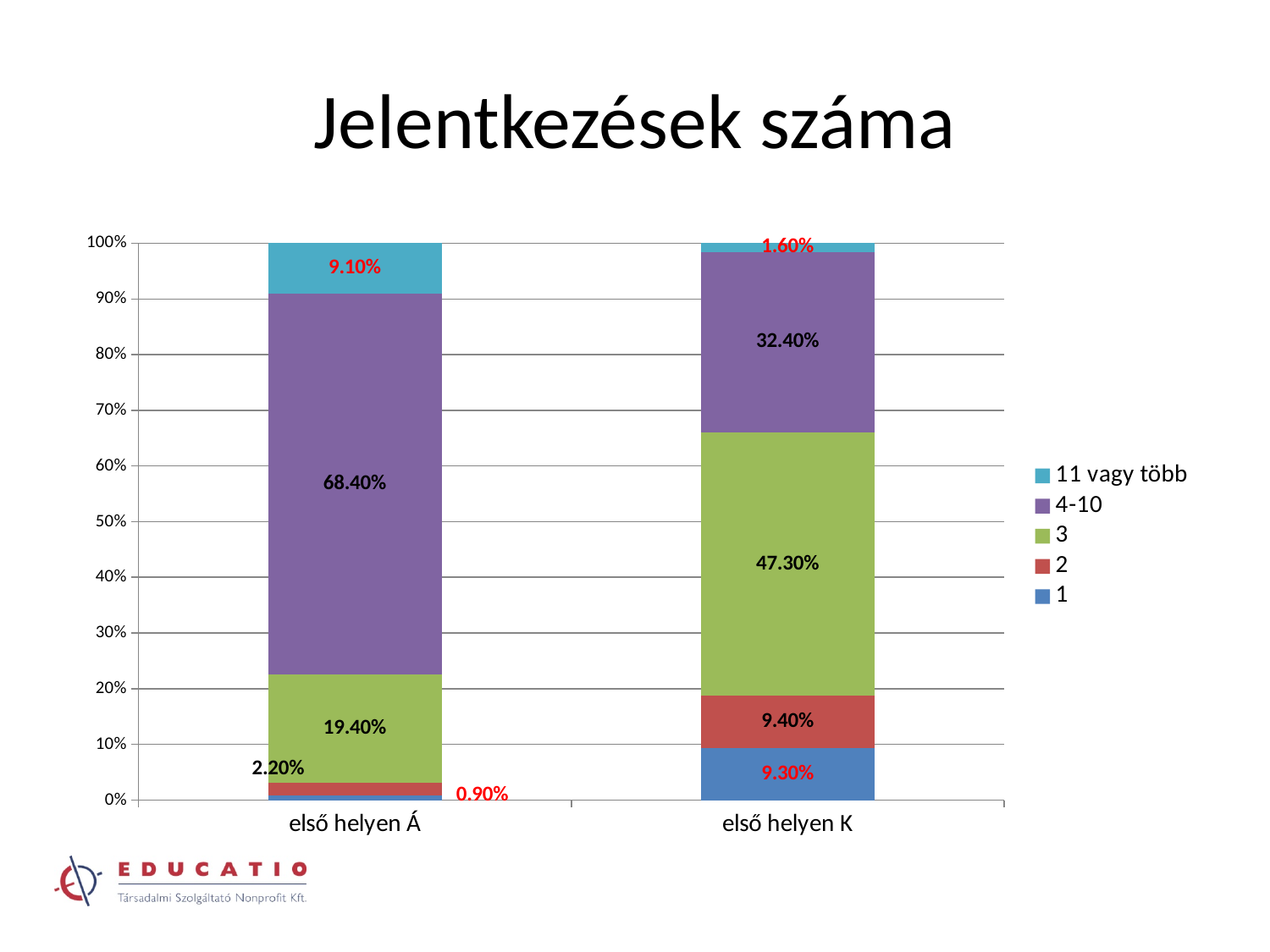
Which series has the smallest share in the első helyen Á bar? 1 Which category has the larger value for the 2 series, első helyen Á or első helyen K? első helyen K What is the value of the 4-10 series for első helyen Á? 68.40% What is the difference between the 4-10 values for első helyen Á and első helyen K? 36.00% Which series has the largest share in the első helyen K bar? 3 What is the value of the 11 vagy több series for első helyen K? 1.60% What kind of chart is shown on the slide? stacked bar chart How many series does the legend list? 5 What is the title of the chart? Jelentkezések száma How many categories are shown on the x axis? 2 What is the value of the 3 series for első helyen K? 47.30% What is the value of the 1 series for első helyen Á? 0.90%